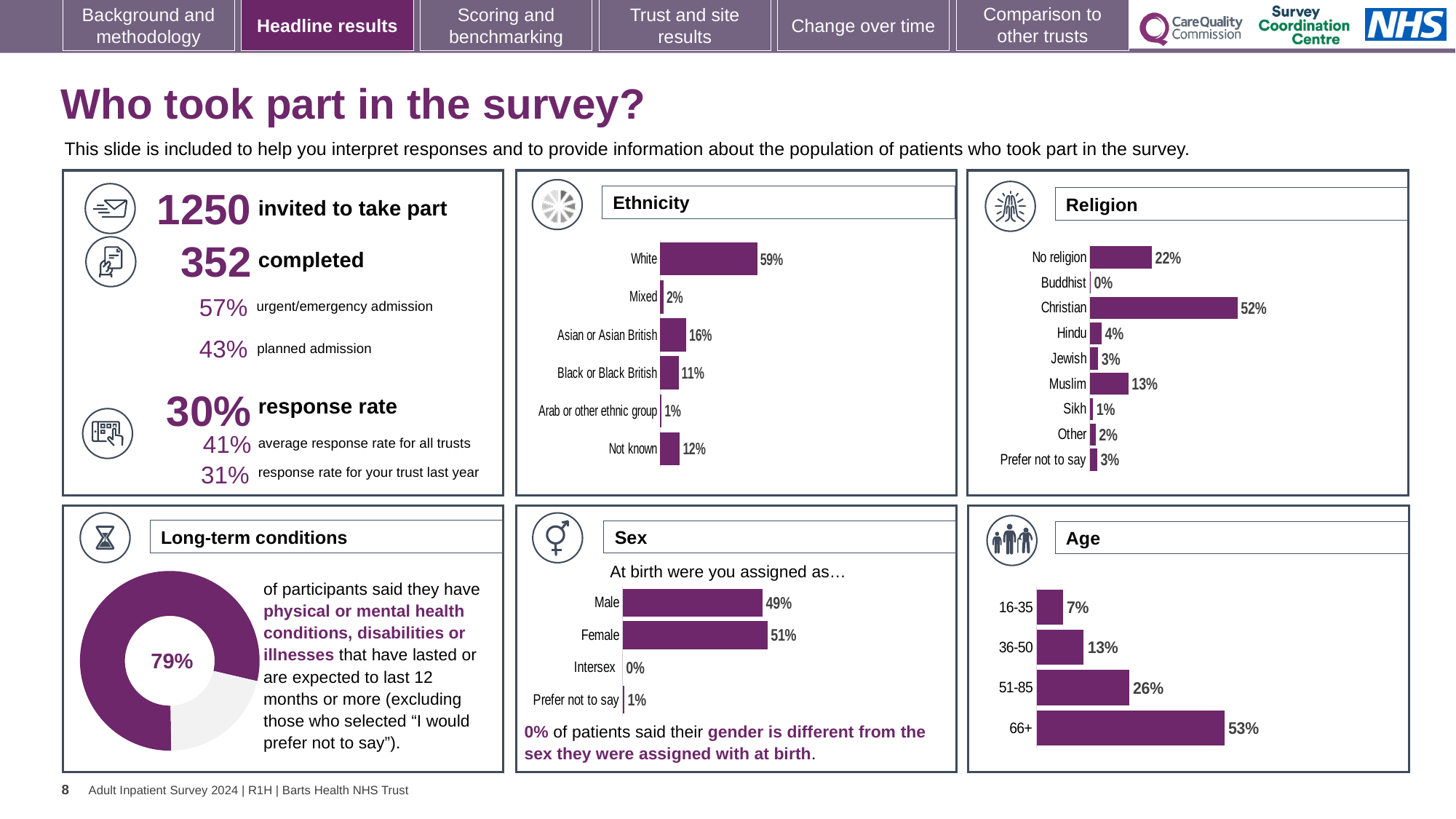
In the Religion chart, which category has the highest value? Christian In the Sex chart, what is the difference between the Female and Male percentages? 2% What kind of chart is the Long-term conditions chart? Doughnut chart How many categories are shown in the Religion chart? 9 In the Ethnicity chart, what percentage of participants were White? 59% In the Religion chart, which is larger: No religion or Muslim? No religion In the Age chart, do the values rise or fall as the age groups get older? Rise In the Ethnicity chart, what is the difference between Asian or Asian British and Black or Black British? 5% In the Age chart, what is the value for the 66+ group? 53% In the Age chart, which age group has the lowest value? 16-35 How many categories are shown in the Ethnicity chart? 6 In the Long-term conditions chart, what share of participants said they have physical or mental health conditions, disabilities or illnesses? 79%